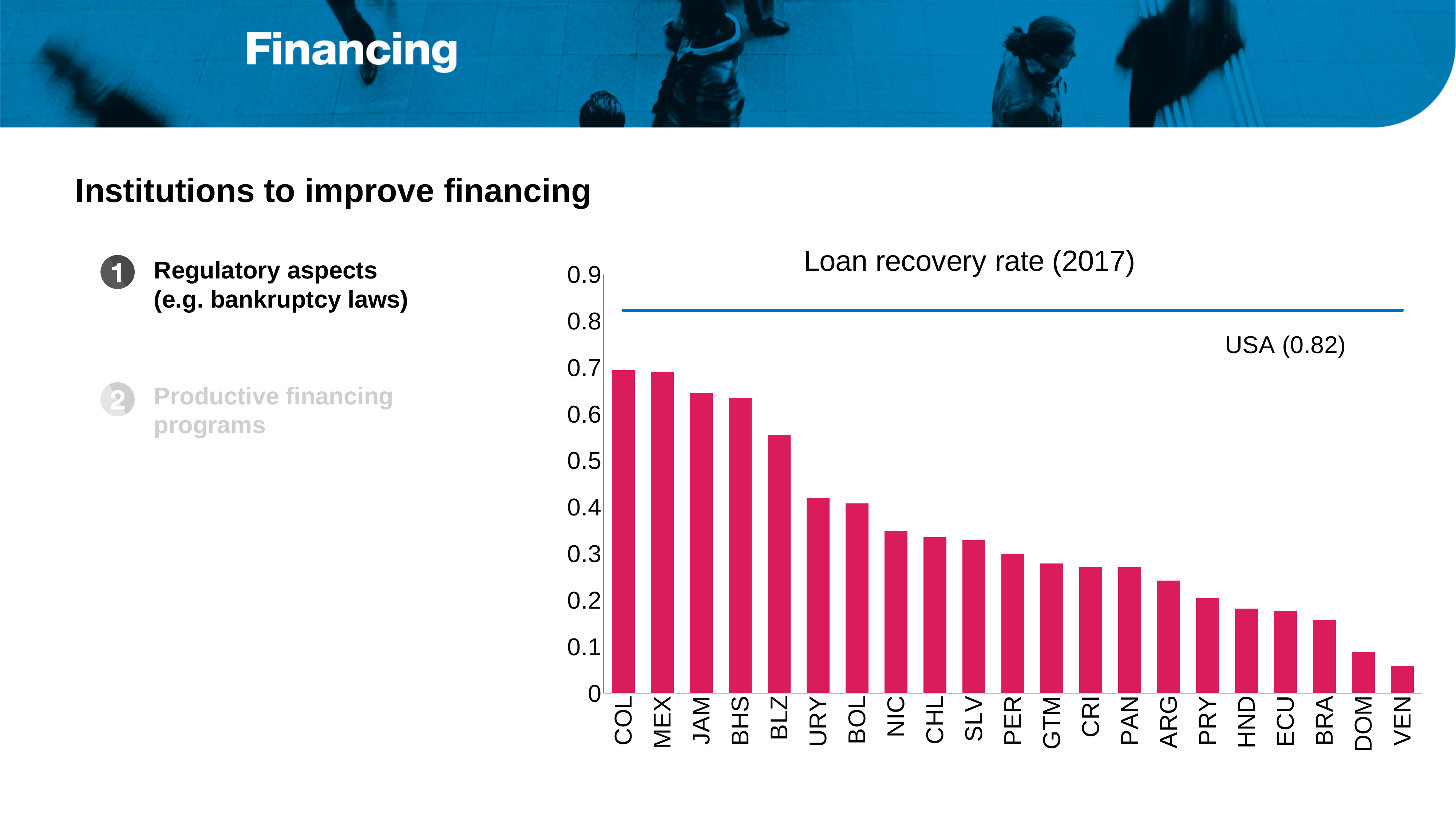
What kind of chart is shown on the slide? bar chart Do the bar values rise or fall from left to right along the x axis? fall How many countries are plotted as bars in the chart? 21 Which country has the lowest loan recovery rate in the chart? VEN Is the value for VEN greater or less than 0.1? less What is the title of the chart? Loan recovery rate (2017) Is the value for COL greater or less than 0.8? less What loan recovery rate is given for the USA reference line? 0.82 Which has the larger loan recovery rate, JAM or PER? JAM Is the value for URY greater or less than 0.5? less Which has the larger loan recovery rate, BRA or NIC? NIC